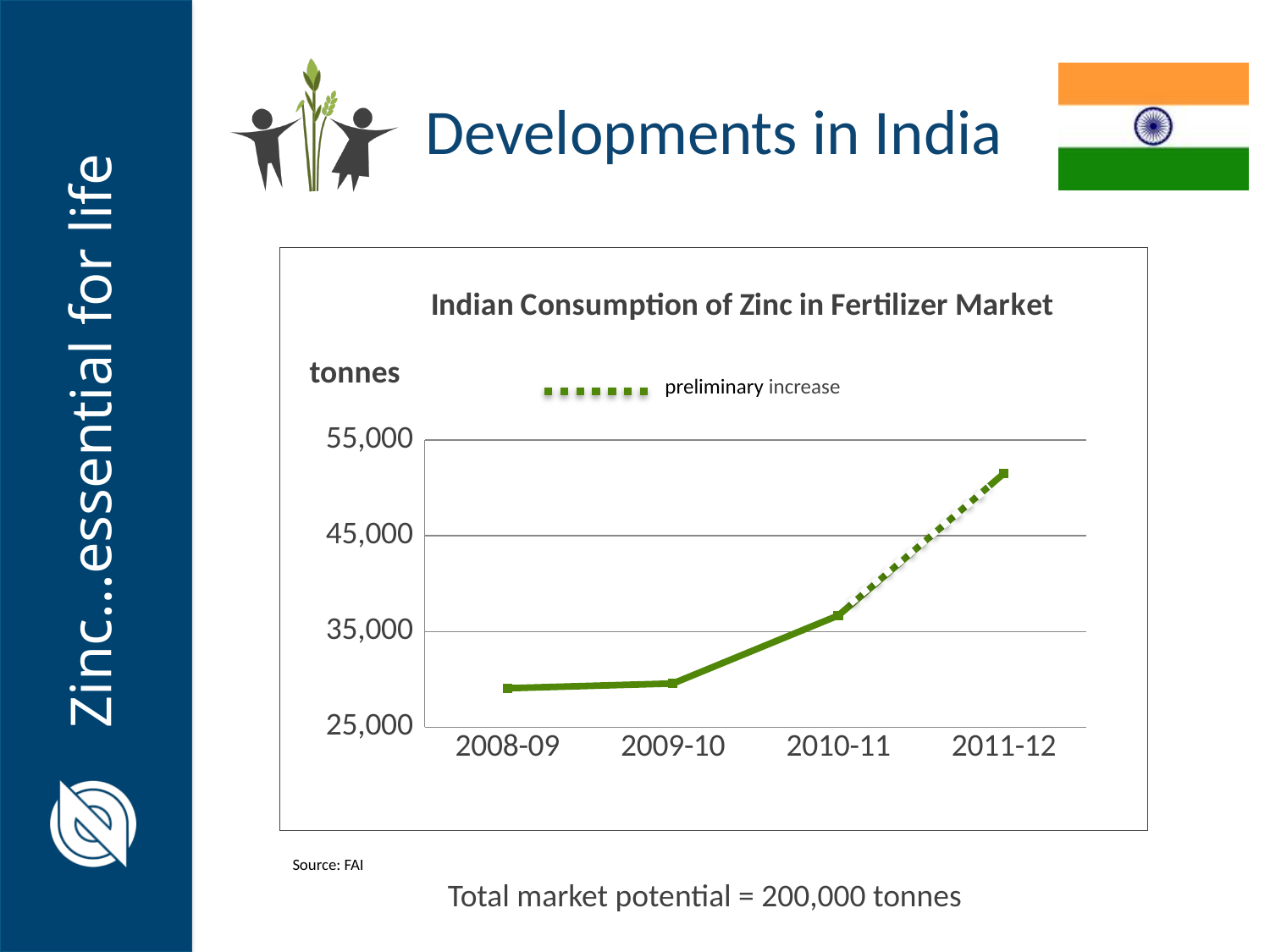
What unit is the y axis of the chart measured in? tonnes What is the title of the chart? Indian Consumption of Zinc in Fertilizer Market Is the value for 2009-10 greater or less than 25,000? greater Is the value for 2010-11 greater or less than 35,000? greater Is the value for 2011-12 greater or less than 45,000? greater Which is larger, the value for 2009-10 or the value for 2010-11? 2010-11 Do the values rise or fall from 2008-09 to 2011-12? rise How many years are plotted on the x axis of the chart? 4 Which year has the highest zinc consumption in the chart? 2011-12 Which is larger, the value for 2010-11 or the value for 2011-12? 2011-12 What kind of chart is shown on the slide? line chart